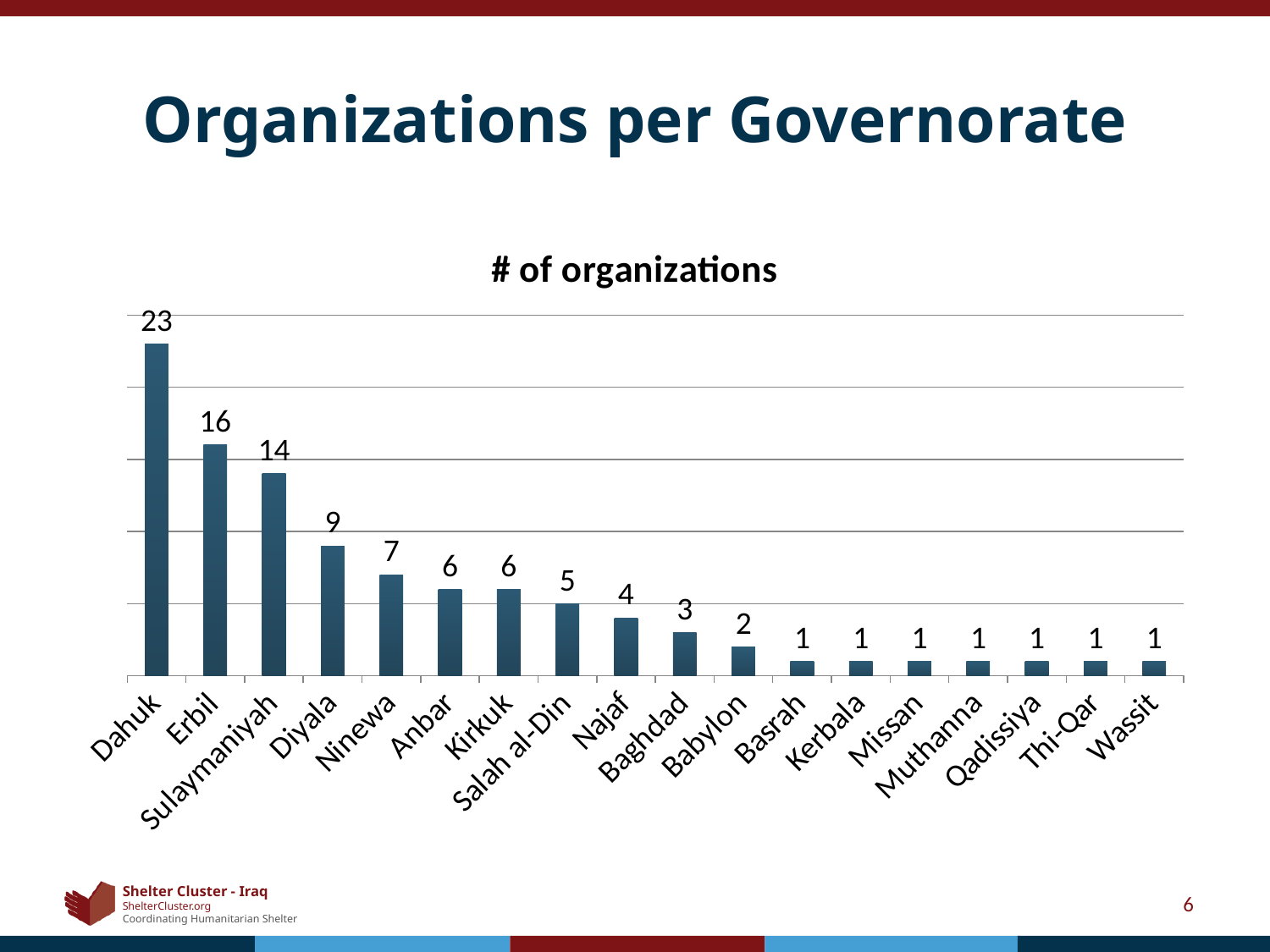
How many governorates have exactly 1 organization? 7 What is the number of organizations for Dahuk? 23 What is the number of organizations for Babylon? 2 What is the number of organizations for Salah al-Din? 5 Do the values rise or fall moving from left to right along the x axis? Fall What type of chart is shown on the slide? Bar chart What is the difference in the number of organizations between Dahuk and Erbil? 7 Which governorate has the highest number of organizations? Dahuk Which has more organizations, Ninewa or Baghdad? Ninewa How many governorates are shown on the chart? 18 What is the difference in the number of organizations between Diyala and Najaf? 5 What is the number of organizations for Sulaymaniyah? 14